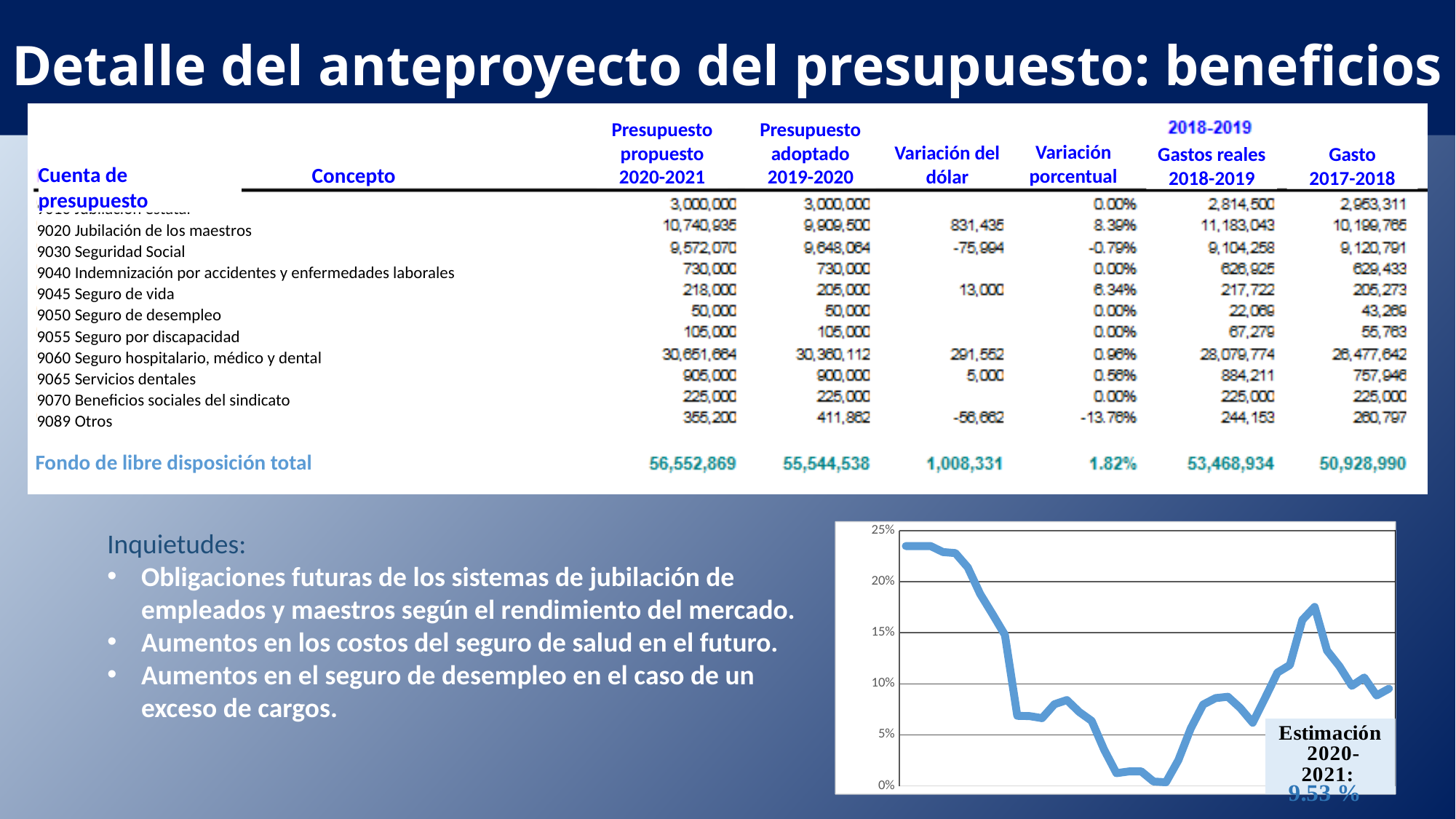
Is the peak of the line near the right side of the chart greater or less than 15%? greater What estimated value for 2020-2021 is printed on the line chart? 9.53 % Is the first value of the line at the left of the chart greater or less than 20%? greater Is the lowest point of the line greater or less than 5%? less What kind of chart is shown at the bottom right of the slide? line chart Overall, does the line in the chart rise or fall from left to right? fall How many lines (series) are plotted in the chart? 1 Is the starting value of the line larger or smaller than its ending value? larger What is the highest value shown on the y axis of the line chart? 25%